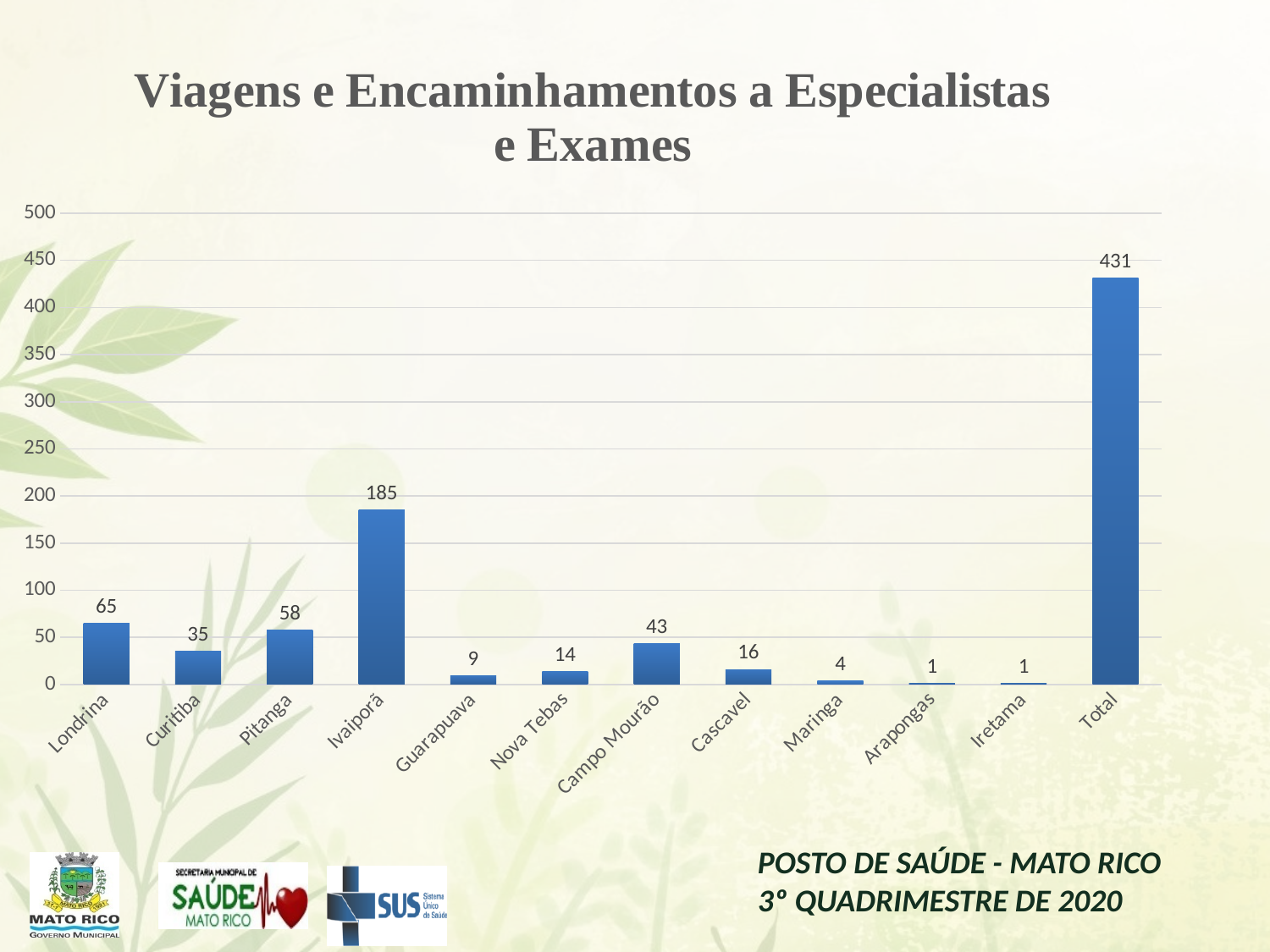
How many bars are shown in the chart, including the Total bar? 12 Excluding the Total bar, which city has the highest value? Ivaiporã What is the difference between the values for Londrina and Curitiba? 30 What is the value for Campo Mourão? 43 What is the value for Guarapuava? 9 What is the value for Ivaiporã? 185 Which has a larger value, Cascavel or Nova Tebas? Cascavel What kind of chart is shown on the slide? Bar chart Is the value for Ivaiporã greater or less than 150? greater What is the difference between the values for Ivaiporã and Pitanga? 127 What is the value shown for the Total bar? 431 What is the title of the chart? Viagens e Encaminhamentos a Especialistas e Exames